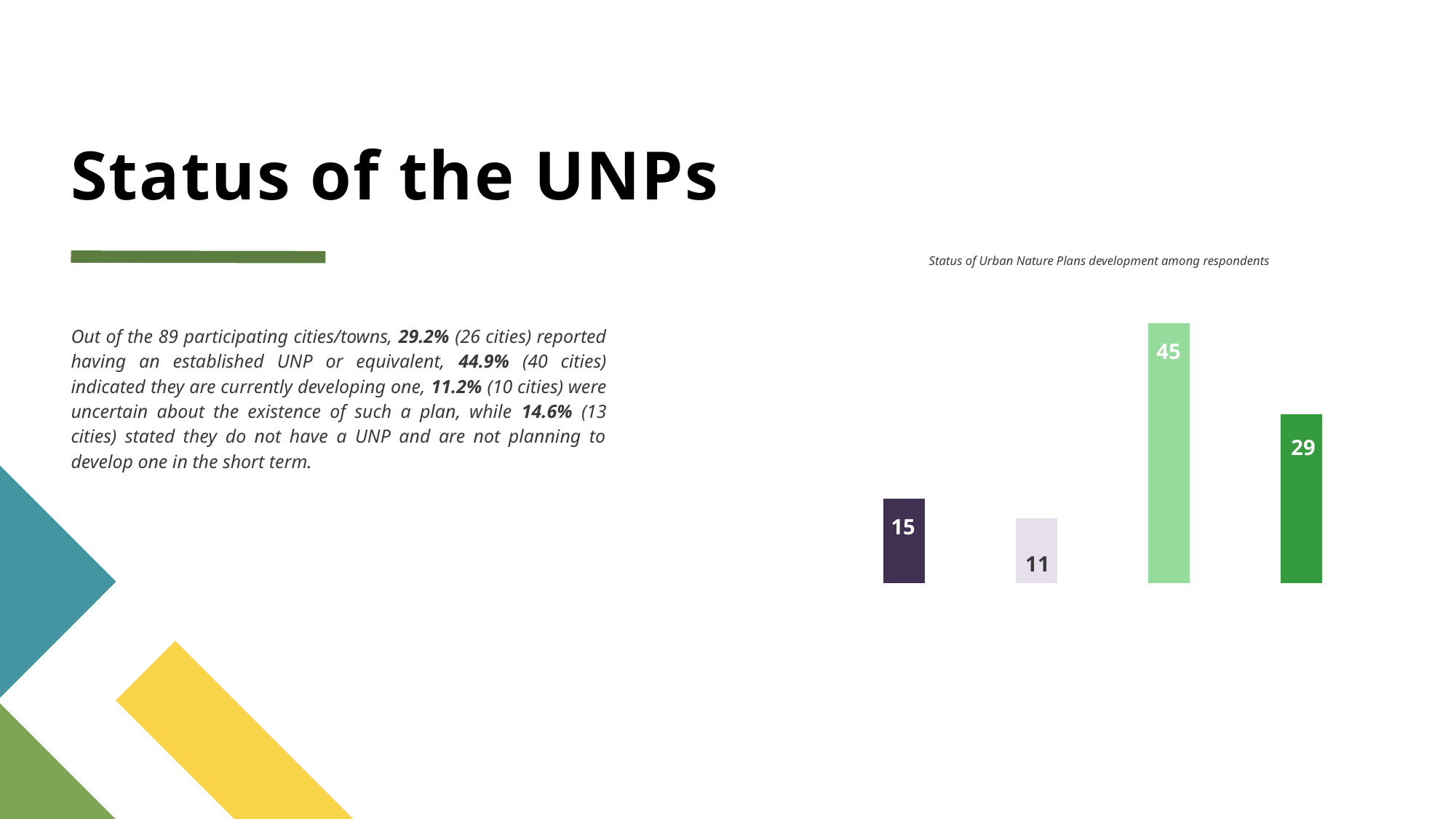
How many bars are plotted in the chart? 4 What is the value of the fourth (rightmost) bar in the chart? 29 What is the lowest value shown in the chart? 11 What is the difference between the third bar (45) and the fourth bar (29) in the chart? 16 What is the value of the first (leftmost) bar in the chart? 15 Which is larger in the chart, the first bar from the left or the second bar from the left? the first bar (15) What is the title of the chart on the slide? Status of Urban Nature Plans development among respondents What is the value of the second bar from the left in the chart? 11 What is the highest value shown in the chart? 45 What is the difference between the first bar (15) and the second bar (11) in the chart? 4 What type of chart is shown on the slide? bar chart What is the value of the third bar from the left in the chart? 45